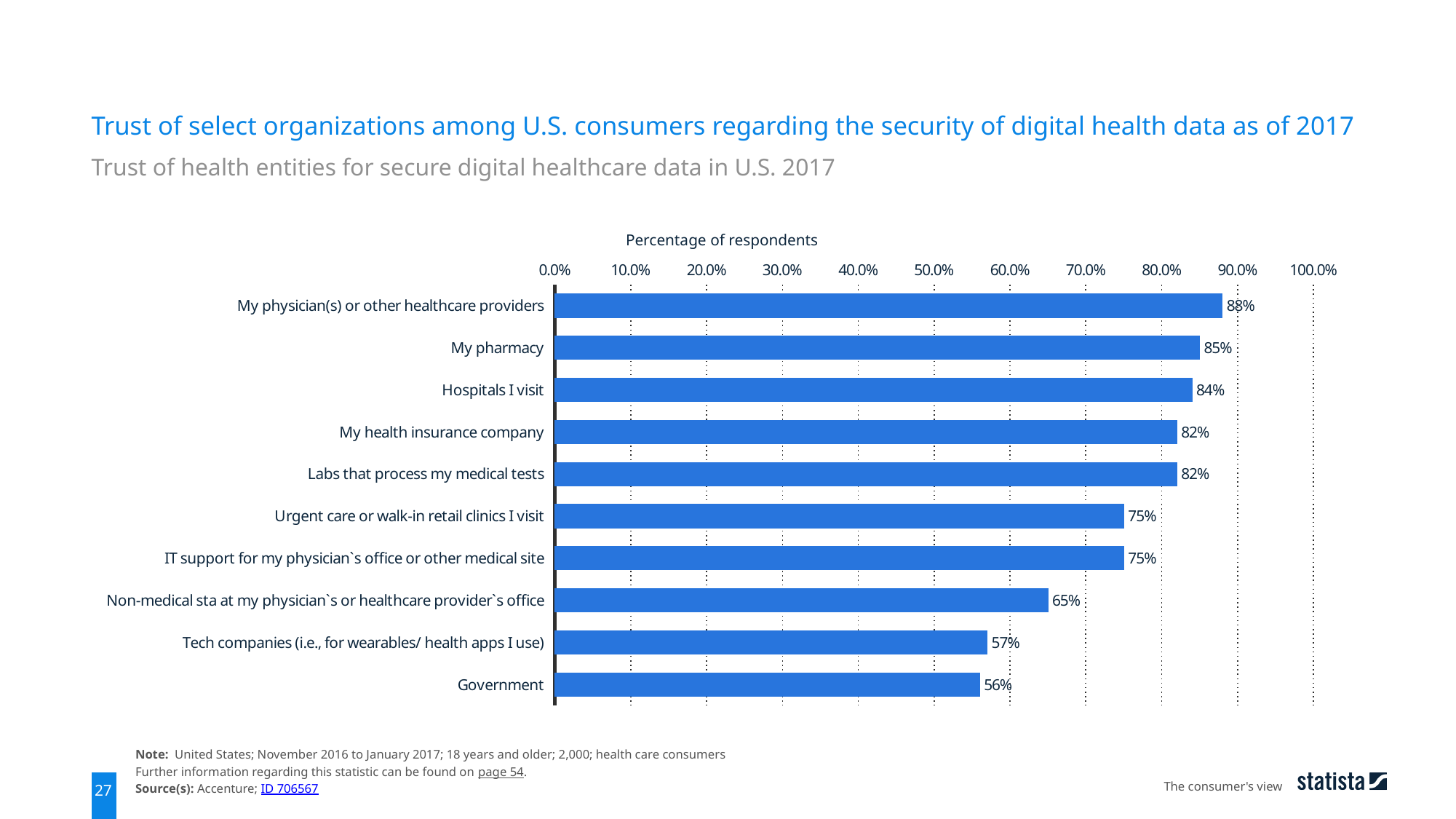
What is the value for Government? 56% Which organization has the lowest share of respondents trusting it? Government Which has a higher value: My health insurance company or Urgent care or walk-in retail clinics I visit? My health insurance company What is the label of the value axis? Percentage of respondents What is the difference in percentage points between My physician(s) or other healthcare providers and Government? 32 How many organizations are shown in the chart? 10 Which organization has the highest share of respondents trusting it? My physician(s) or other healthcare providers What is the value for Tech companies (i.e., for wearables/ health apps I use)? 57% Is the value for Non-medical sta at my physician`s or healthcare provider`s office greater or less than 70.0%? less What type of chart is shown on the slide? Bar chart What is the difference in percentage points between Hospitals I visit and Non-medical sta at my physician`s or healthcare provider`s office? 19 What percentage of respondents trust their pharmacy with the security of digital health data? 85%